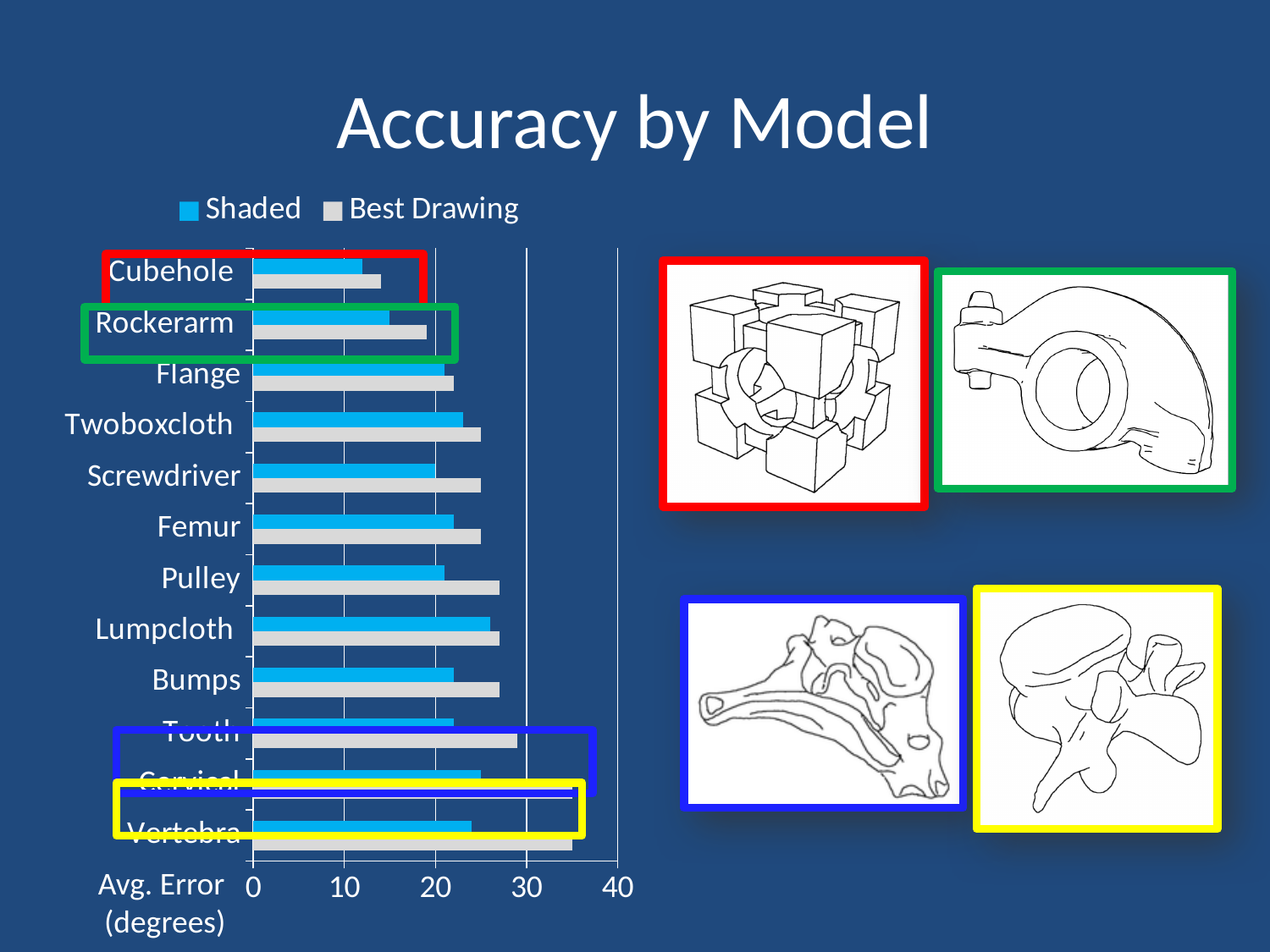
Which is larger: the Best Drawing value for Cervical or the Best Drawing value for Flange? Cervical Is the Best Drawing value for Pulley greater or less than 20? greater Is the Shaded value for Cubehole greater or less than 20? less Which model has the lowest Best Drawing value? Cubehole Which model has the lowest Shaded value? Cubehole Which is larger: the Shaded value for Vertebra or the Shaded value for Cubehole? Vertebra Is the Best Drawing value for Vertebra greater or less than 30? greater How many series does the legend list? 2 What kind of chart is shown on the slide? bar chart What is the label on the horizontal axis of the chart? Avg. Error (degrees) How many models (categories) are plotted in the chart? 12